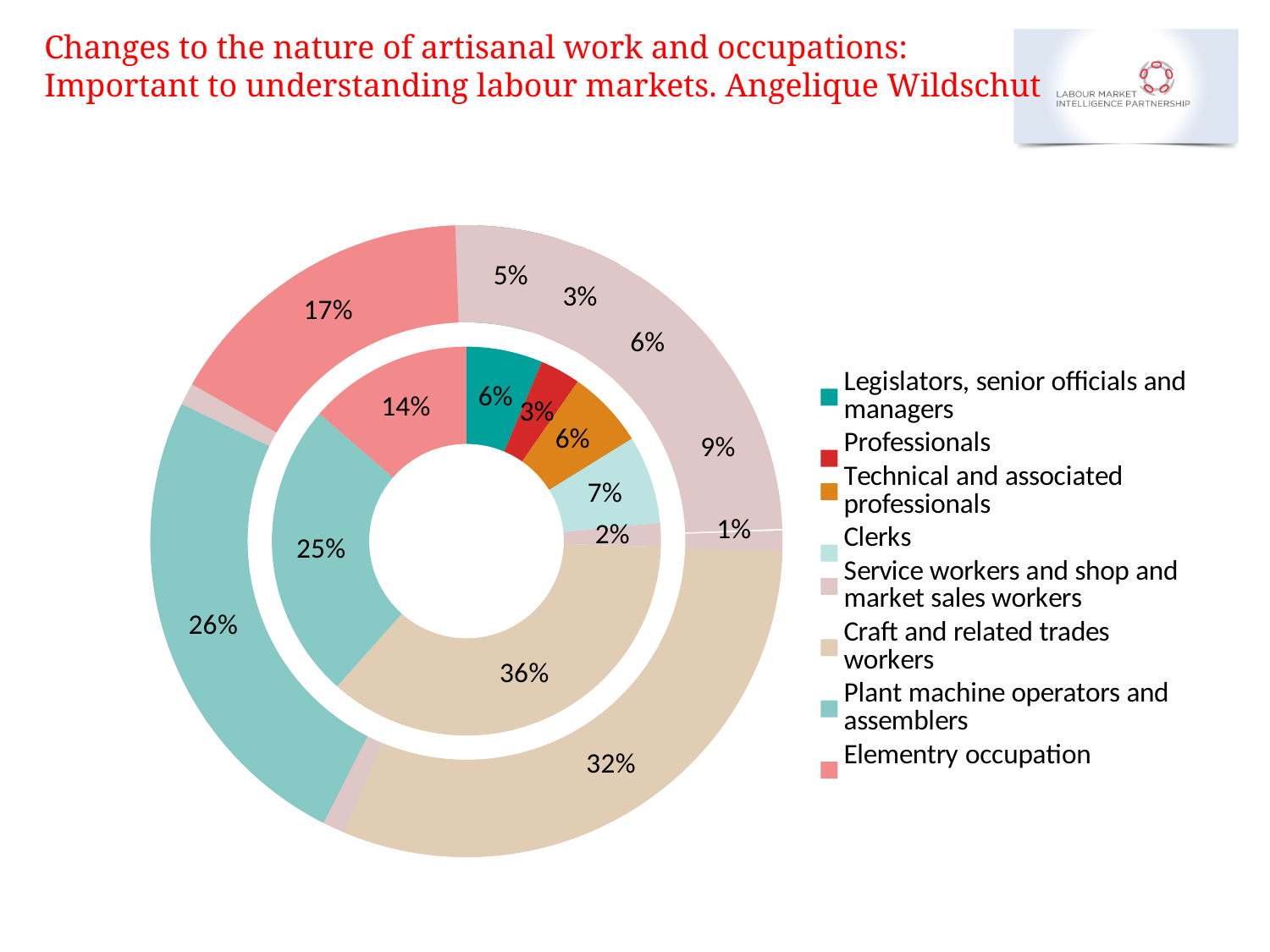
How many rings (series) does the doughnut chart have? 2 In the inner ring, what is the value for Plant machine operators and assemblers? 25% In the inner ring, what is the value for Craft and related trades workers? 36% In the inner ring, what is the value for Elementry occupation? 14% What is the largest value shown in the outer ring? 32% Which category has the smallest share in the inner ring? Service workers and shop and market sales workers In the inner ring, which is larger: Legislators, senior officials and managers or Professionals? Legislators, senior officials and managers In the inner ring, what is the value for Clerks? 7% In the inner ring, what is the difference between Craft and related trades workers and Plant machine operators and assemblers? 11% What kind of chart is shown on the slide? Doughnut chart How many categories does the legend list? 8 Which category has the largest share in the inner ring? Craft and related trades workers